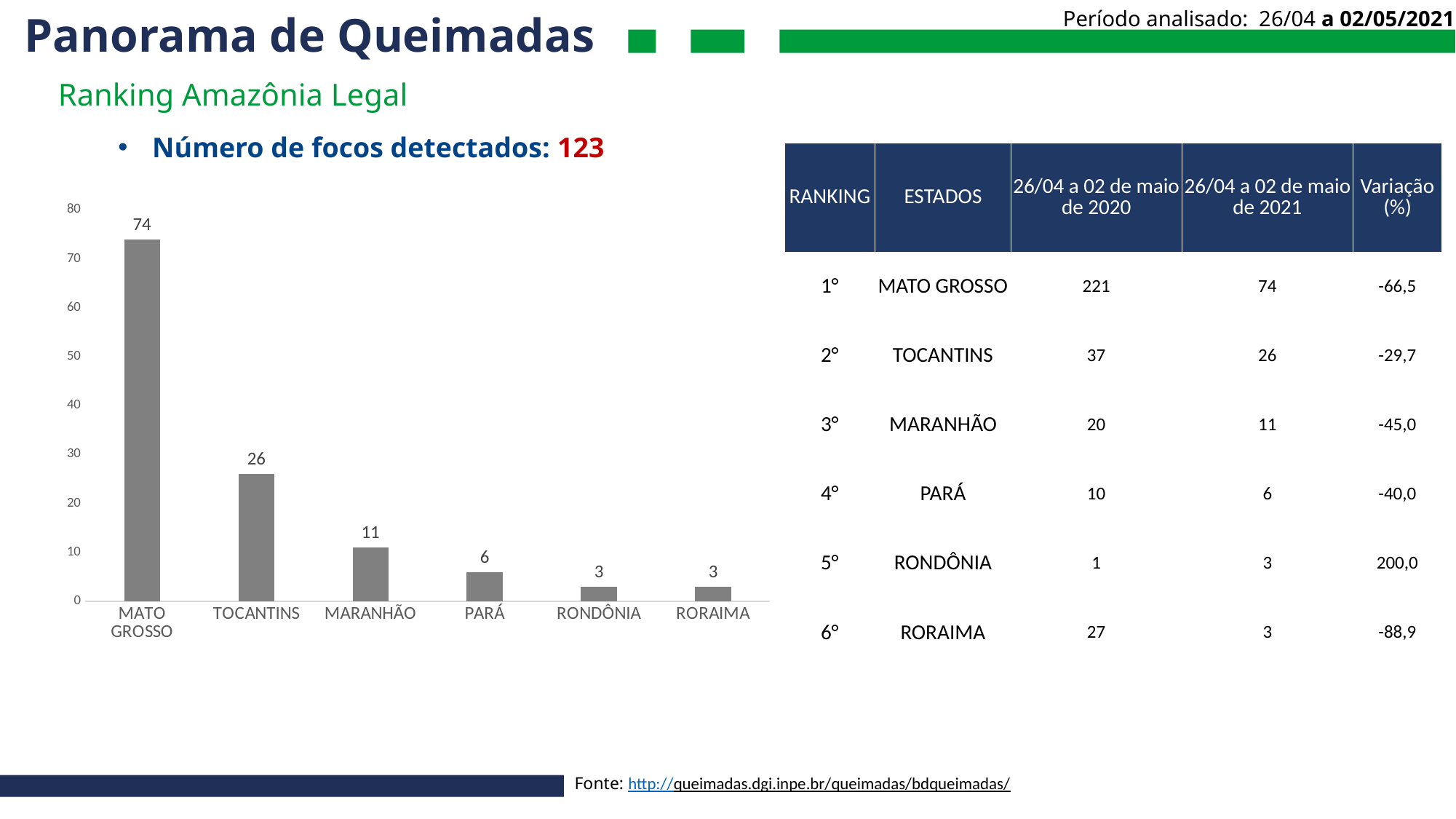
What is the value for MARANHÃO in the bar chart? 11 Which is larger in the bar chart, the value for MARANHÃO or the value for PARÁ? MARANHÃO What kind of chart is shown on the slide? bar chart What is the value for TOCANTINS in the bar chart? 26 What is the value for RONDÔNIA in the bar chart? 3 How many categories are shown in the bar chart? 6 What is the difference between the values for MATO GROSSO and TOCANTINS in the bar chart? 48 What is the value for PARÁ in the bar chart? 6 Do the values in the bar chart rise or fall from left to right along the x axis? fall What is the value for MATO GROSSO in the bar chart? 74 Is the value for MATO GROSSO in the bar chart greater or less than 70? greater Which category has the highest value in the bar chart? MATO GROSSO